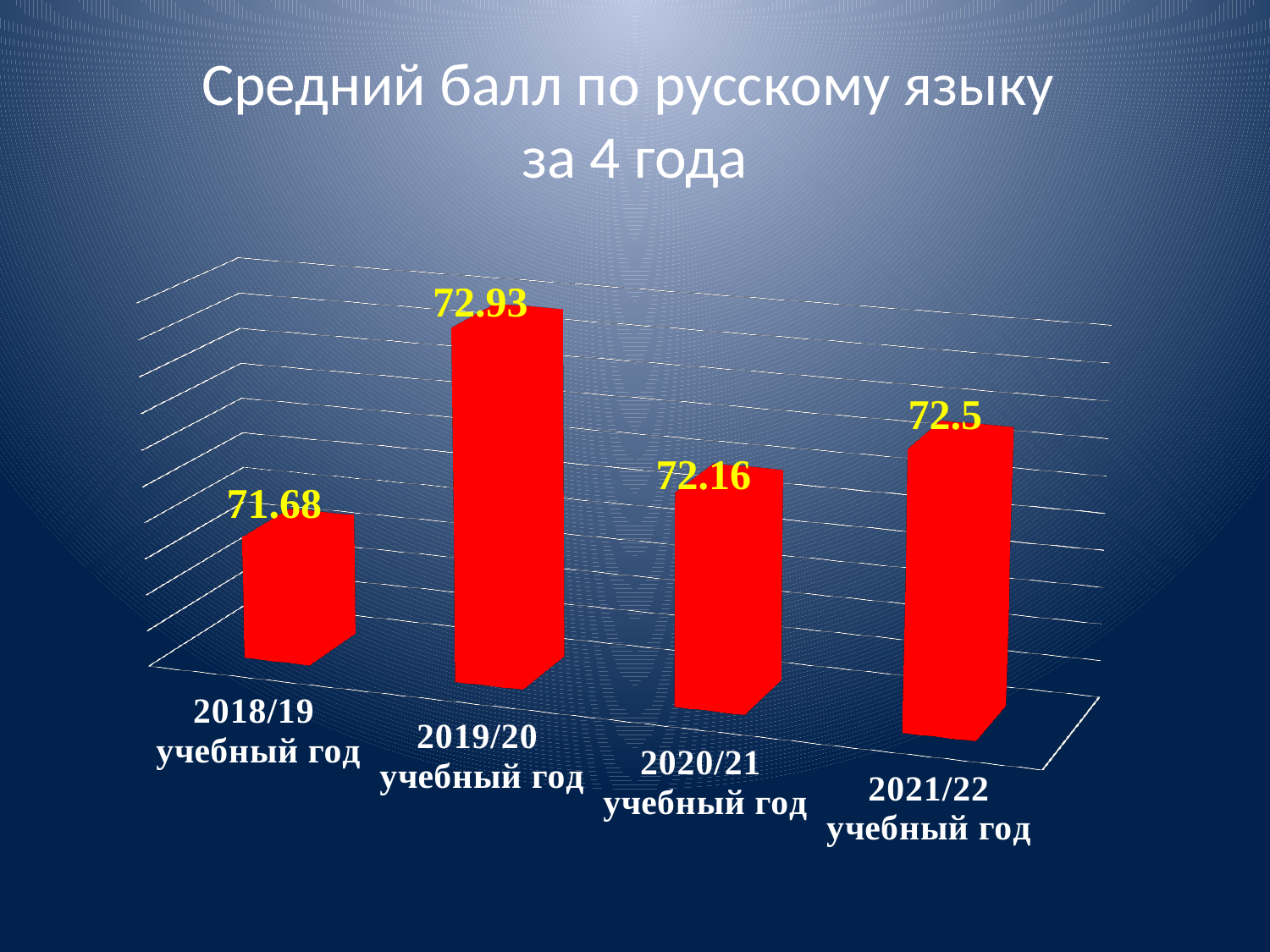
What kind of chart is shown on the slide? Bar chart What is the title of the slide? Средний балл по русскому языку за 4 года What is the difference between the average scores for 2019/20 and 2018/19? 1.25 What is the average Russian language score for the 2021/22 academic year? 72.5 What is the average Russian language score for the 2018/19 academic year? 71.68 Which academic year has the highest average score? 2019/20 учебный год What is the difference between the average scores for 2021/22 and 2020/21? 0.34 Which is larger, the average score for 2020/21 or for 2021/22? 2021/22 What is the average Russian language score for the 2020/21 academic year? 72.16 Which academic year has the lowest average score? 2018/19 учебный год How many academic years are shown in the chart? 4 What is the average Russian language score for the 2019/20 academic year? 72.93